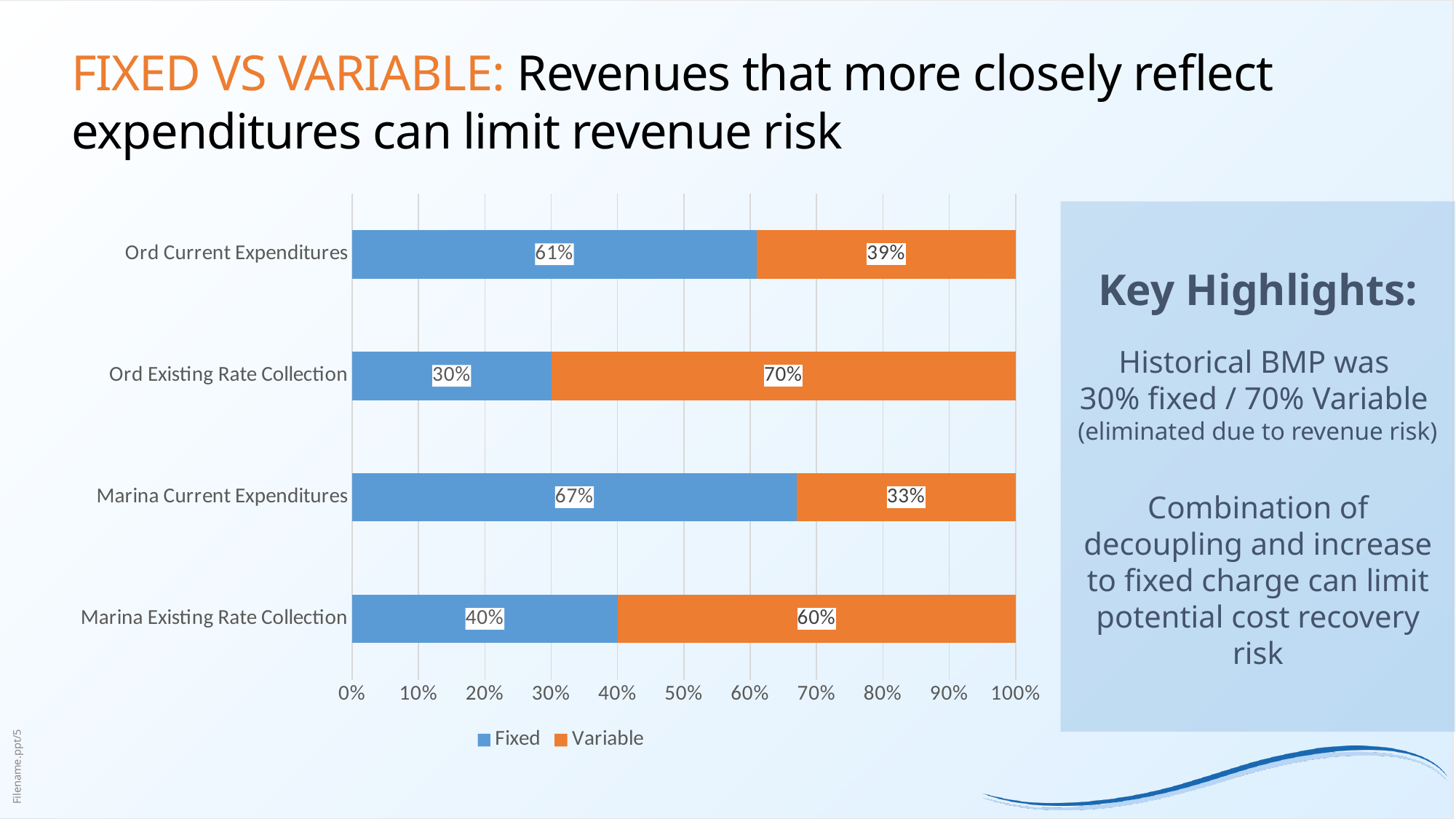
Which category has the highest Fixed value? Marina Current Expenditures Which category has the lowest Fixed value? Ord Existing Rate Collection What is the Variable value for Ord Existing Rate Collection? 70% What kind of chart is shown on the slide? Stacked bar chart What is the Fixed value for Ord Current Expenditures? 61% What is the total of the stacked bar for Ord Existing Rate Collection? 100% How many series does the legend list? 2 What is the difference between the Fixed values for Marina Current Expenditures and Marina Existing Rate Collection? 27% What is the Fixed value for Marina Current Expenditures? 67% Which is larger, the Variable value for Ord Current Expenditures or the Variable value for Marina Current Expenditures? Ord Current Expenditures How many categories are shown on the chart? 4 What is the Variable value for Marina Existing Rate Collection? 60%